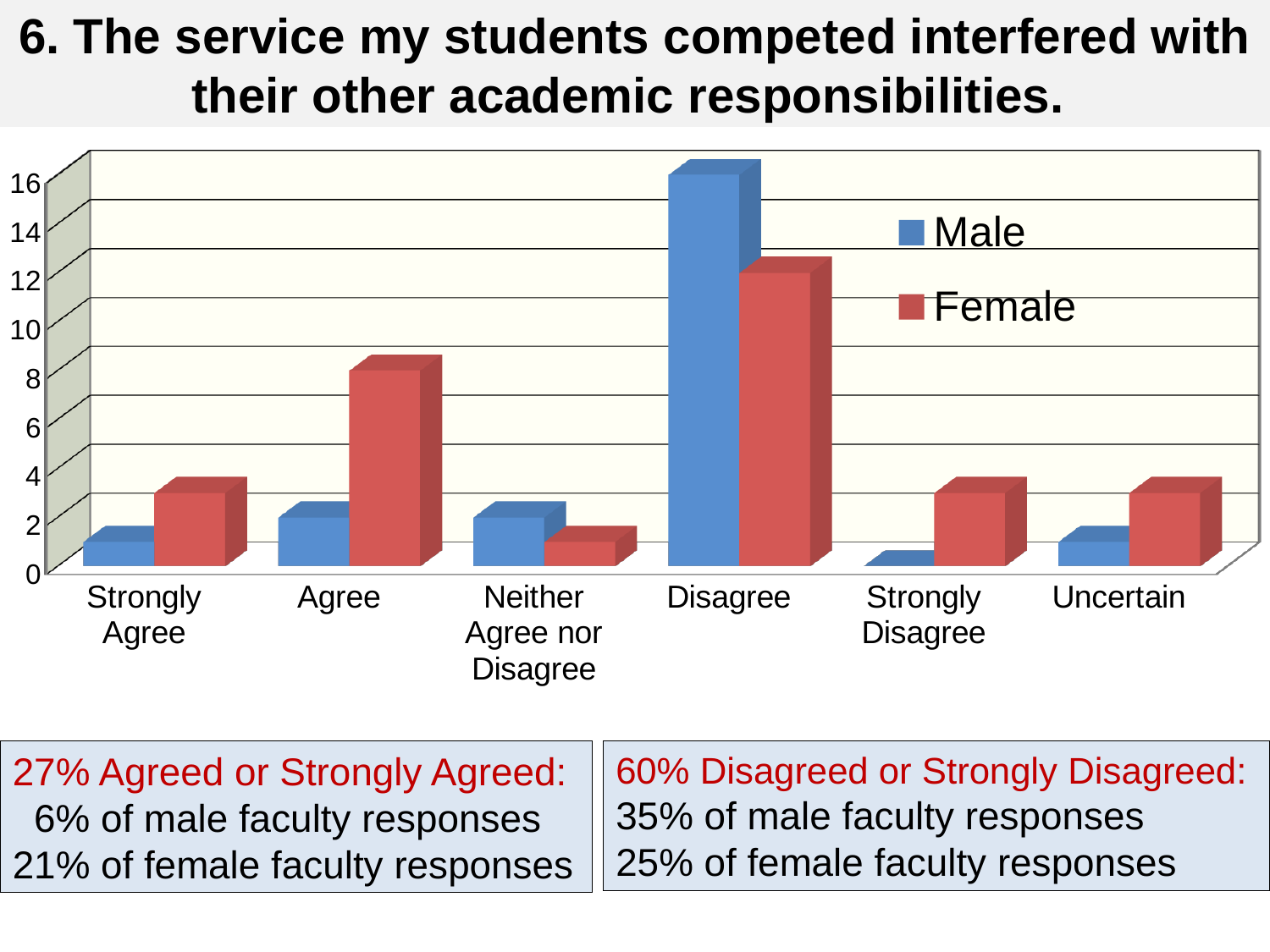
What kind of chart is shown on the slide? bar chart For Disagree, which is larger, the Male value or the Female value? Male How many series does the legend list? 2 Is the Female value for Agree greater or less than 6? greater How many response categories are shown on the x axis? 6 Which category has the highest Female value? Disagree Is the Female value for Disagree greater or less than 10? greater Which category has the lowest Male value? Strongly Disagree For Agree, which is larger, the Male value or the Female value? Female Which category has the highest Male value? Disagree Which colour represents the Female series in the chart? red Is the Male value for Disagree greater or less than 14? greater